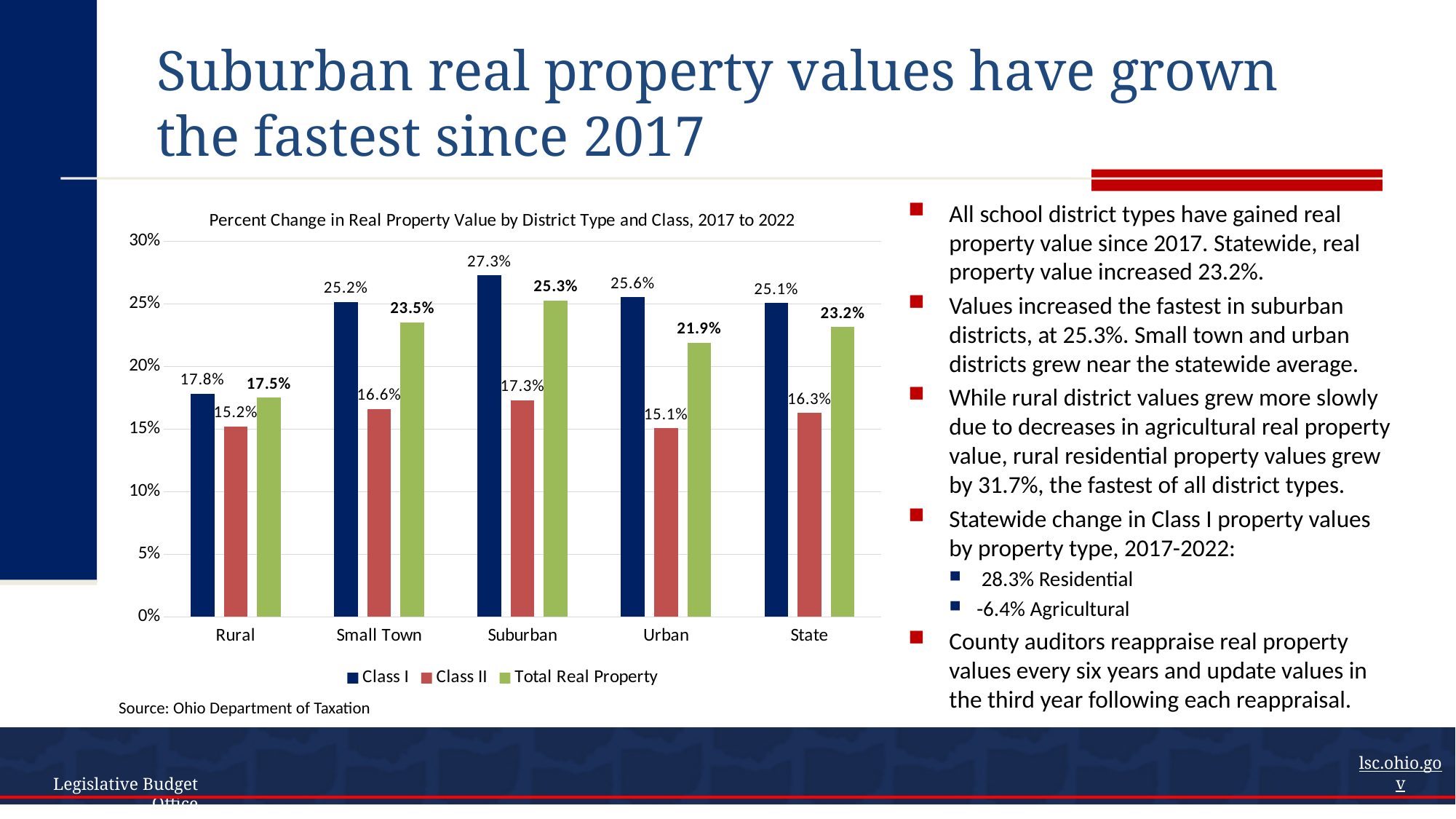
Which district type has the highest Total Real Property percent change? Suburban What is the Class II percent change for Rural districts? 15.2% What is the Class I percent change for Suburban districts? 27.3% How many series does the legend list? 3 How many district type categories are shown on the x axis? 5 What is the Total Real Property percent change for Urban districts? 21.9% What is the difference between the Class I and Class II percent change for Small Town districts? 8.6% What kind of chart is shown on the slide? bar chart What is the title of the chart? Percent Change in Real Property Value by District Type and Class, 2017 to 2022 Which district type has the lowest Class II percent change? Urban Is the Class I value for Rural districts greater or less than 20%? less Which is larger, the Total Real Property change for Small Town or for State? Small Town